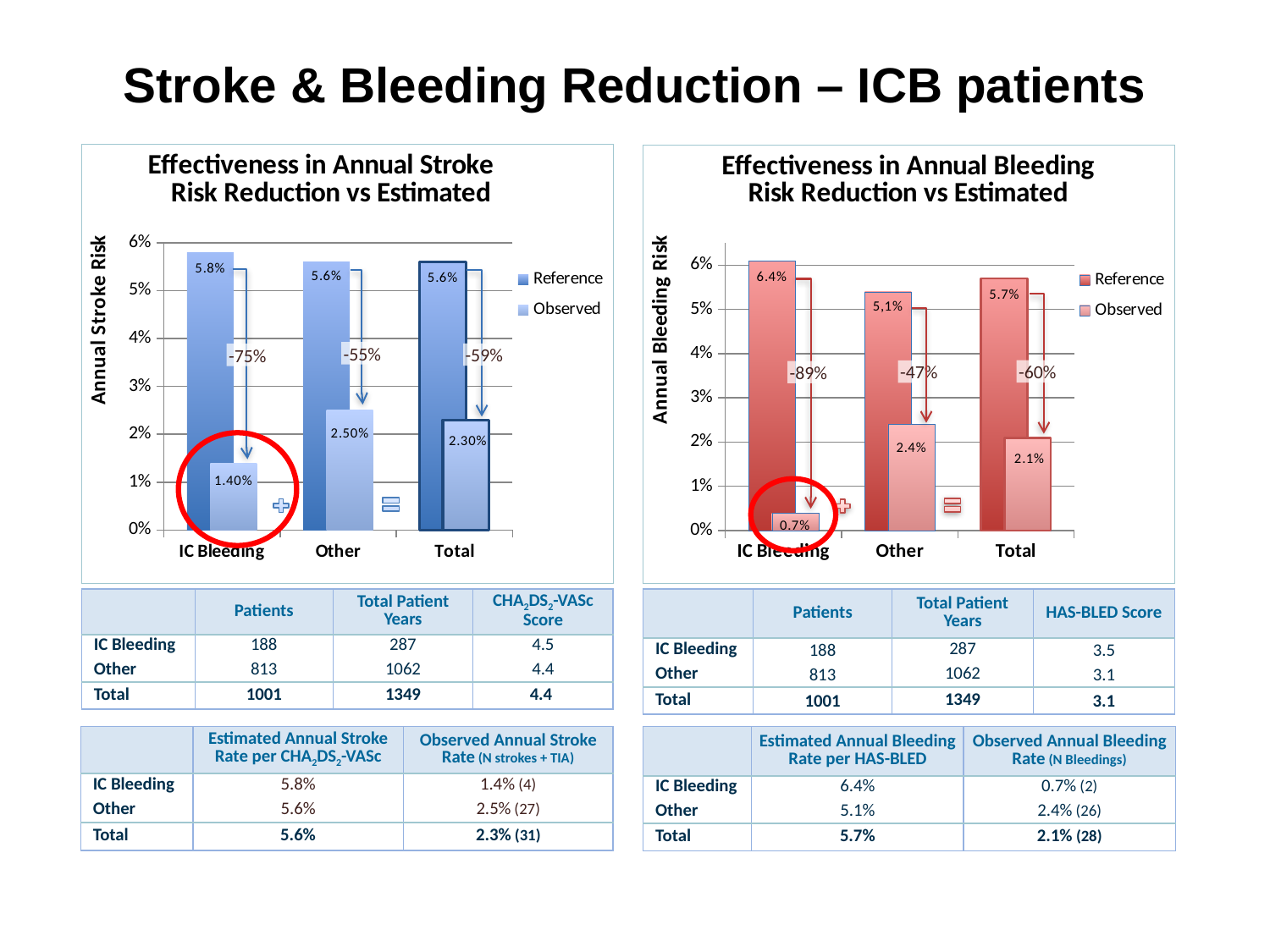
What kind of chart is the Effectiveness in Annual Stroke Risk Reduction vs Estimated chart? bar chart In the Effectiveness in Annual Stroke Risk Reduction vs Estimated chart, what is the Observed value for IC Bleeding? 1.40% In the Effectiveness in Annual Stroke Risk Reduction vs Estimated chart, what is the difference between the Reference and Observed values for IC Bleeding? 4.4% In the Effectiveness in Annual Bleeding Risk Reduction vs Estimated chart, which category has the highest Reference value? IC Bleeding In the Effectiveness in Annual Bleeding Risk Reduction vs Estimated chart, which category has the lowest Observed value? IC Bleeding In the Effectiveness in Annual Bleeding Risk Reduction vs Estimated chart, what is the Reference value for IC Bleeding? 6.4% How many categories are shown on the x axis of the Effectiveness in Annual Stroke Risk Reduction vs Estimated chart? 3 In the Effectiveness in Annual Stroke Risk Reduction vs Estimated chart, is the Observed value for Other greater or less than 2%? greater In the Effectiveness in Annual Bleeding Risk Reduction vs Estimated chart, is the Observed value for Other larger or smaller than the Observed value for Total? larger In the Effectiveness in Annual Bleeding Risk Reduction vs Estimated chart, what is the Observed value for Total? 2.1% How many series does the legend of the Effectiveness in Annual Bleeding Risk Reduction vs Estimated chart list? 2 In the Effectiveness in Annual Stroke Risk Reduction vs Estimated chart, what is the Reference value for Other? 5.6%